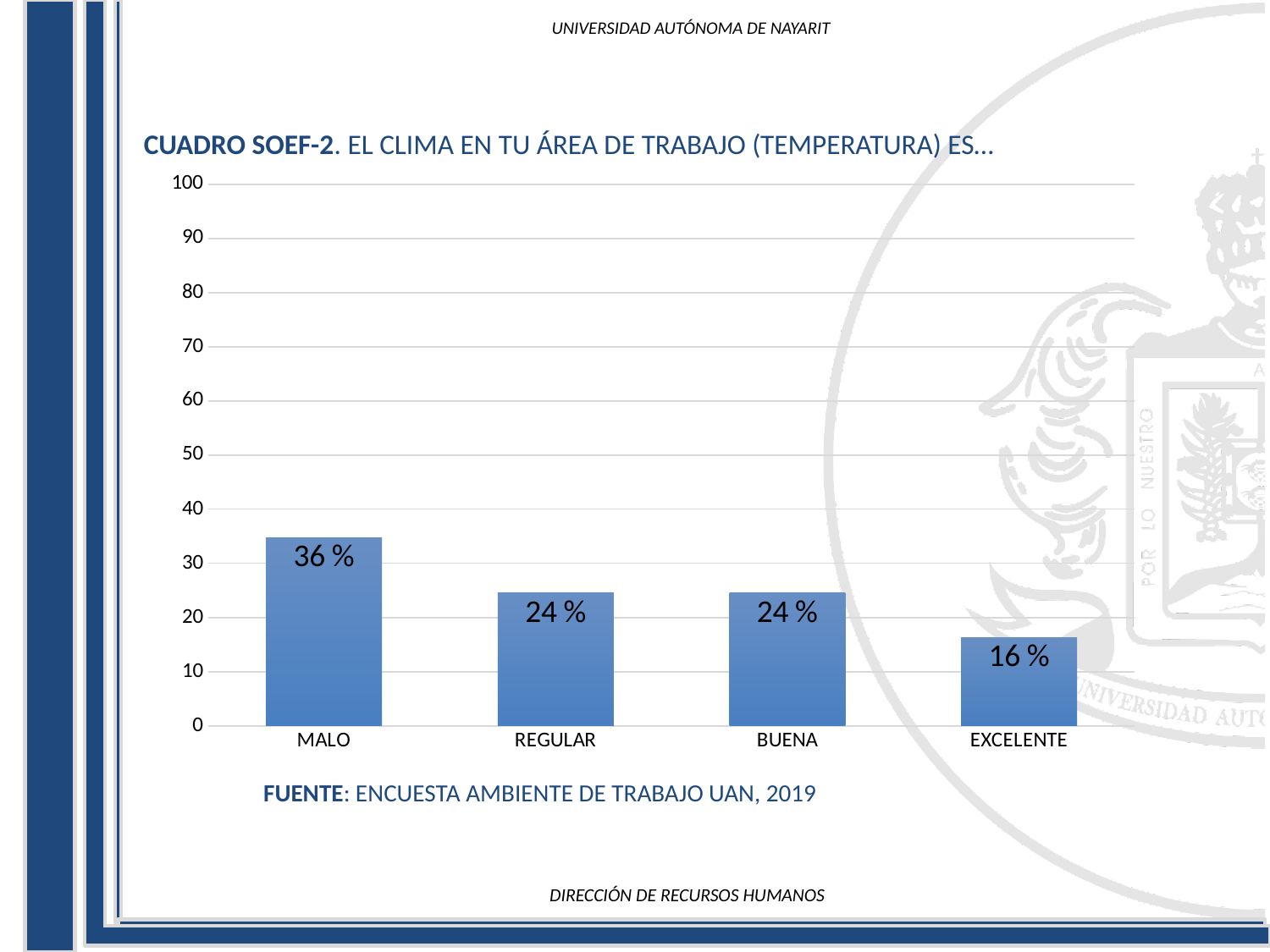
Which is larger, the value for BUENA or the value for EXCELENTE? BUENA How many categories are shown on the x axis? 4 Which category has the lowest value? EXCELENTE What is the value for REGULAR? 24 % What is the value for EXCELENTE? 16 % Which category has the highest value? MALO What kind of chart is shown on the slide? bar chart Is the value for MALO greater or less than 30? greater What is the value for MALO? 36 % What is the source cited below the chart? ENCUESTA AMBIENTE DE TRABAJO UAN, 2019 What is the difference between the values for MALO and EXCELENTE? 20 % What is the difference between the values for MALO and BUENA? 12 %